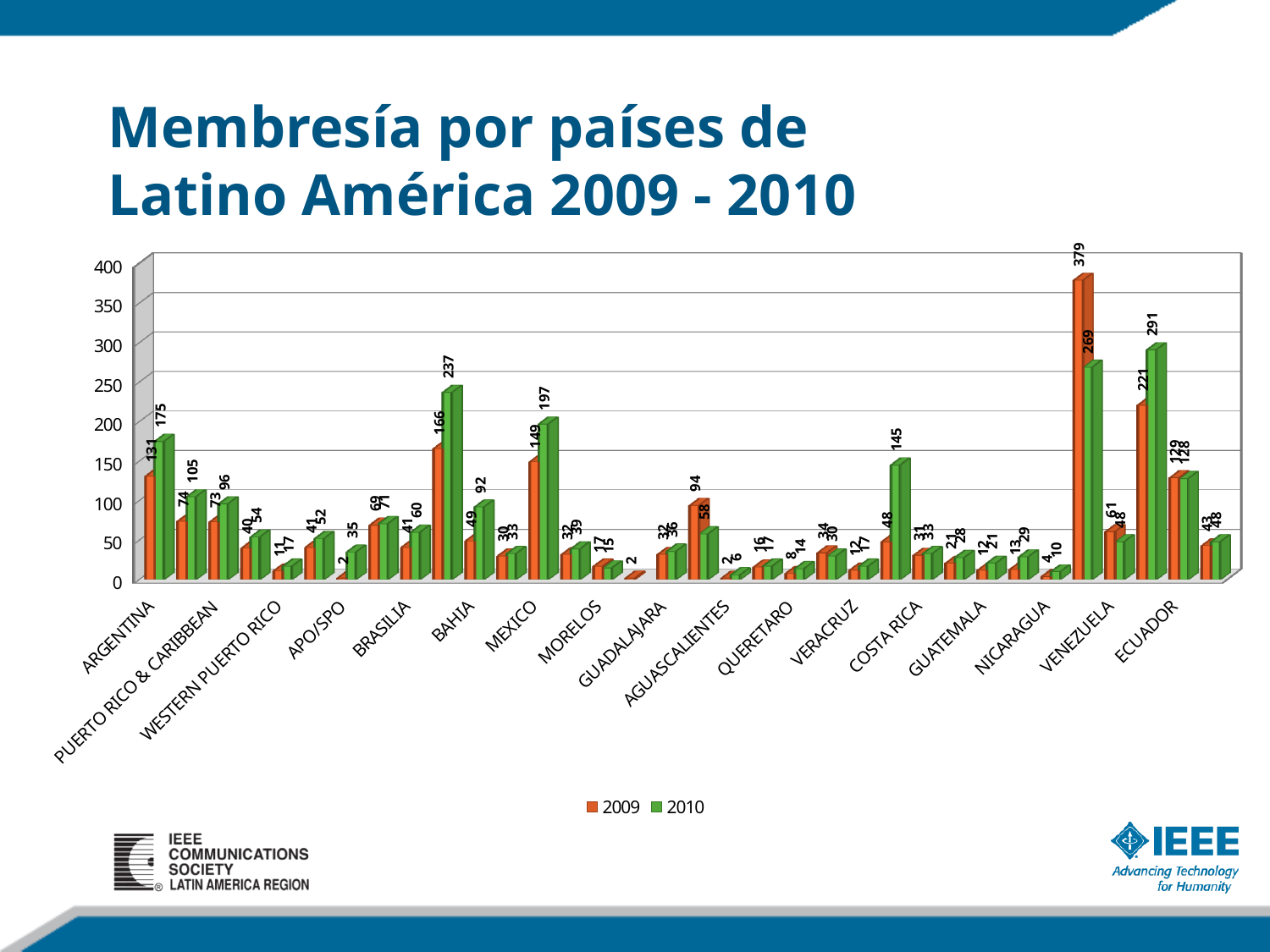
What kind of chart is shown on the slide? bar chart What is the 2010 value for ARGENTINA? 175 Which series is shown in green in the legend? 2010 For ARGENTINA, which year has the larger value, 2009 or 2010? 2010 What is the difference between the 2009 and 2010 values for VENEZUELA? 13 What is the 2010 value for ECUADOR? 128 What is the 2009 value for ARGENTINA? 131 What is the 2009 value for VENEZUELA? 61 How many series does the legend list? 2 Is the 2009 value for VENEZUELA greater or less than 350? less